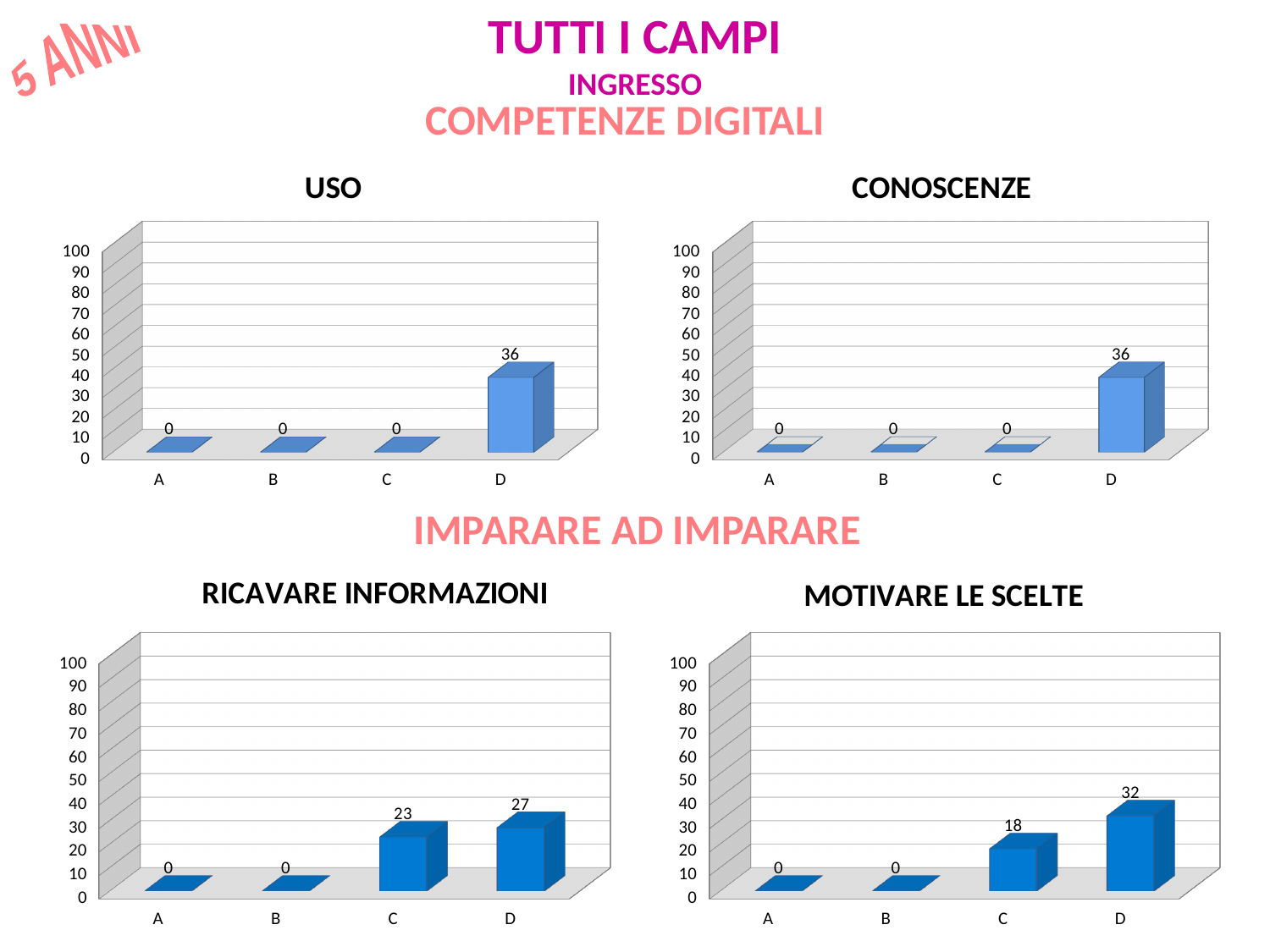
In the RICAVARE INFORMAZIONI chart, what is the difference between the values for D and C? 4 In the MOTIVARE LE SCELTE chart, which category has the highest value? D In the RICAVARE INFORMAZIONI chart, which is larger, the value for C or the value for D? D In the USO chart, what is the value for category A? 0 What kind of chart is the CONOSCENZE chart? Bar chart In the MOTIVARE LE SCELTE chart, what is the value for category D? 32 In the MOTIVARE LE SCELTE chart, what is the difference between the values for D and C? 14 What is the title of the chart at the bottom right of the slide? MOTIVARE LE SCELTE How many categories are shown on the x axis of the USO chart? 4 In the USO chart, what is the value for category D? 36 In the CONOSCENZE chart, what is the value for category D? 36 In the RICAVARE INFORMAZIONI chart, what is the value for category C? 23